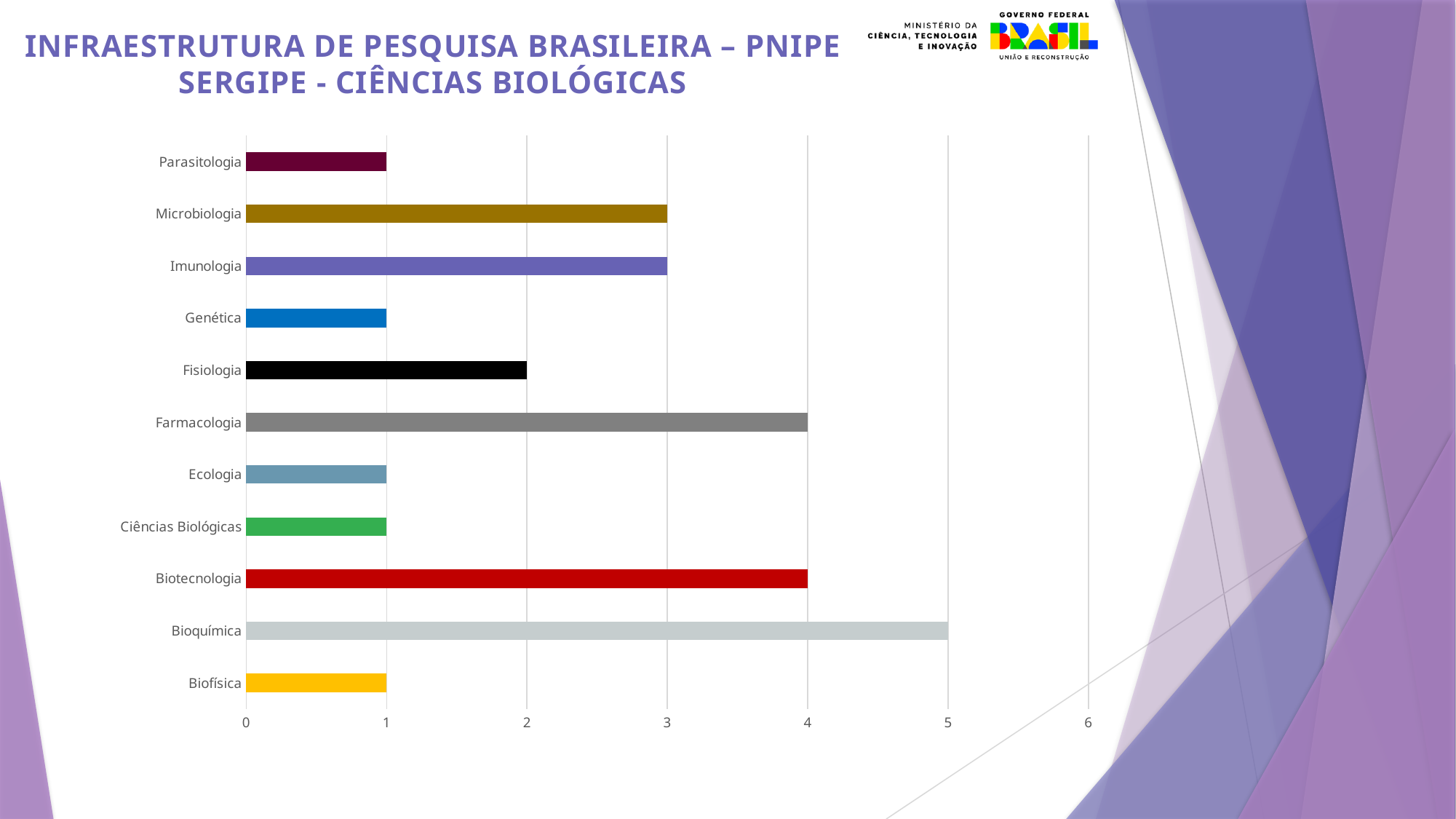
What kind of chart is shown on the slide? bar chart What is the difference between the values for Bioquímica and Fisiologia? 3 What is the difference between the values for Farmacologia and Ecologia? 3 What is the highest value shown on the x axis? 6 What is the value for Bioquímica? 5 Is the value for Biotecnologia greater or less than 3? greater What is the value for Farmacologia? 4 How many categories are shown on the chart? 11 Which category has the highest value? Bioquímica What is the value for Fisiologia? 2 Which is larger, the value for Imunologia or the value for Genética? Imunologia What is the value for Microbiologia? 3